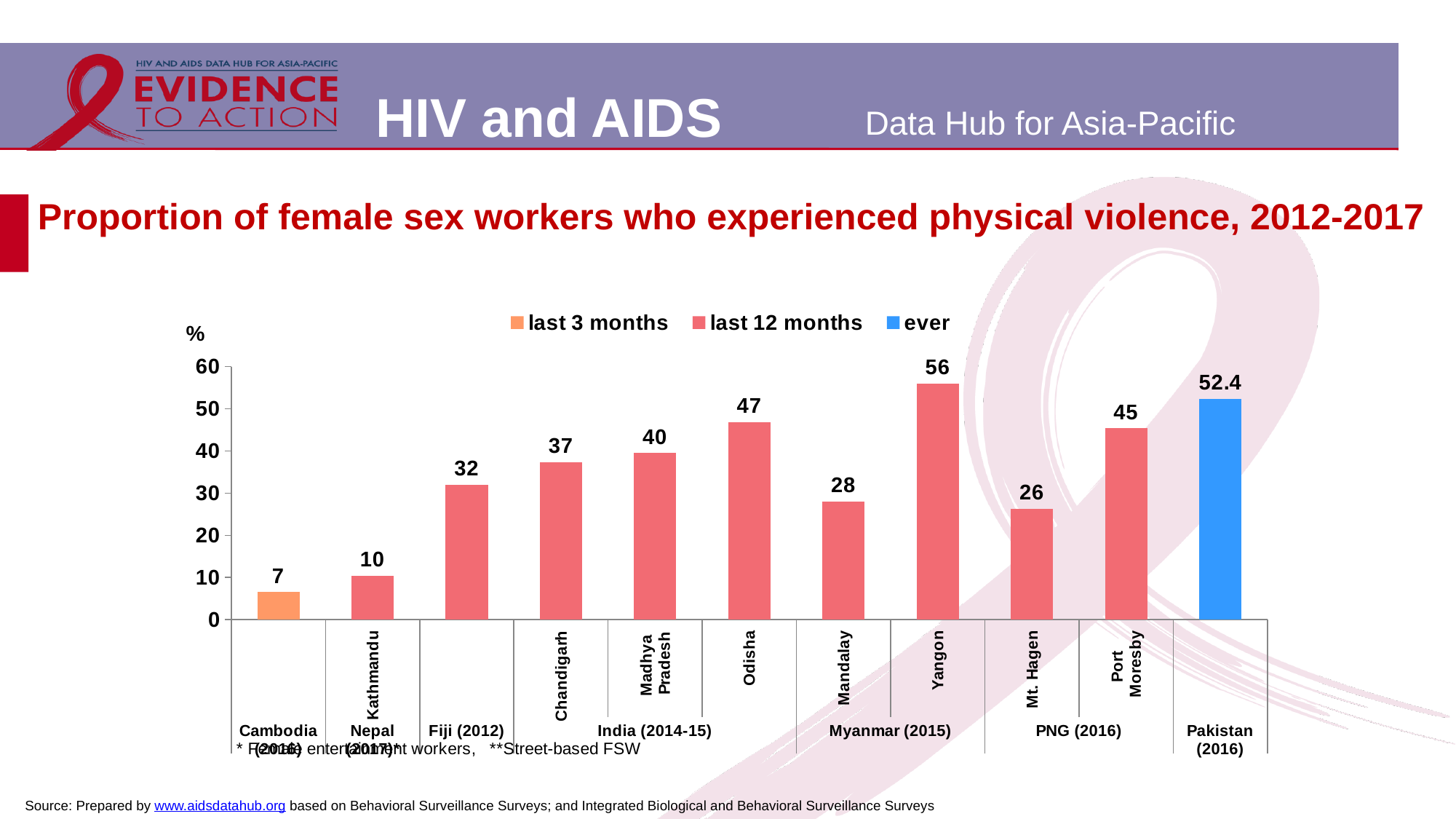
Which location has the highest value? Yangon Which is larger, the value for Port Moresby or the value for Mt. Hagen? Port Moresby Is the value for Fiji (2012) greater or less than 30? greater What is the difference between the values for Yangon and Mandalay? 28 What is the value for Odisha? 47 Which series does the Pakistan (2016) bar belong to, according to the legend? ever What kind of chart is shown on the slide? bar chart How many series does the legend list? 3 How many bars are plotted in the chart? 11 Which location has the lowest value? Cambodia (2016) What is the value for Yangon? 56 What is the value for Pakistan (2016)? 52.4